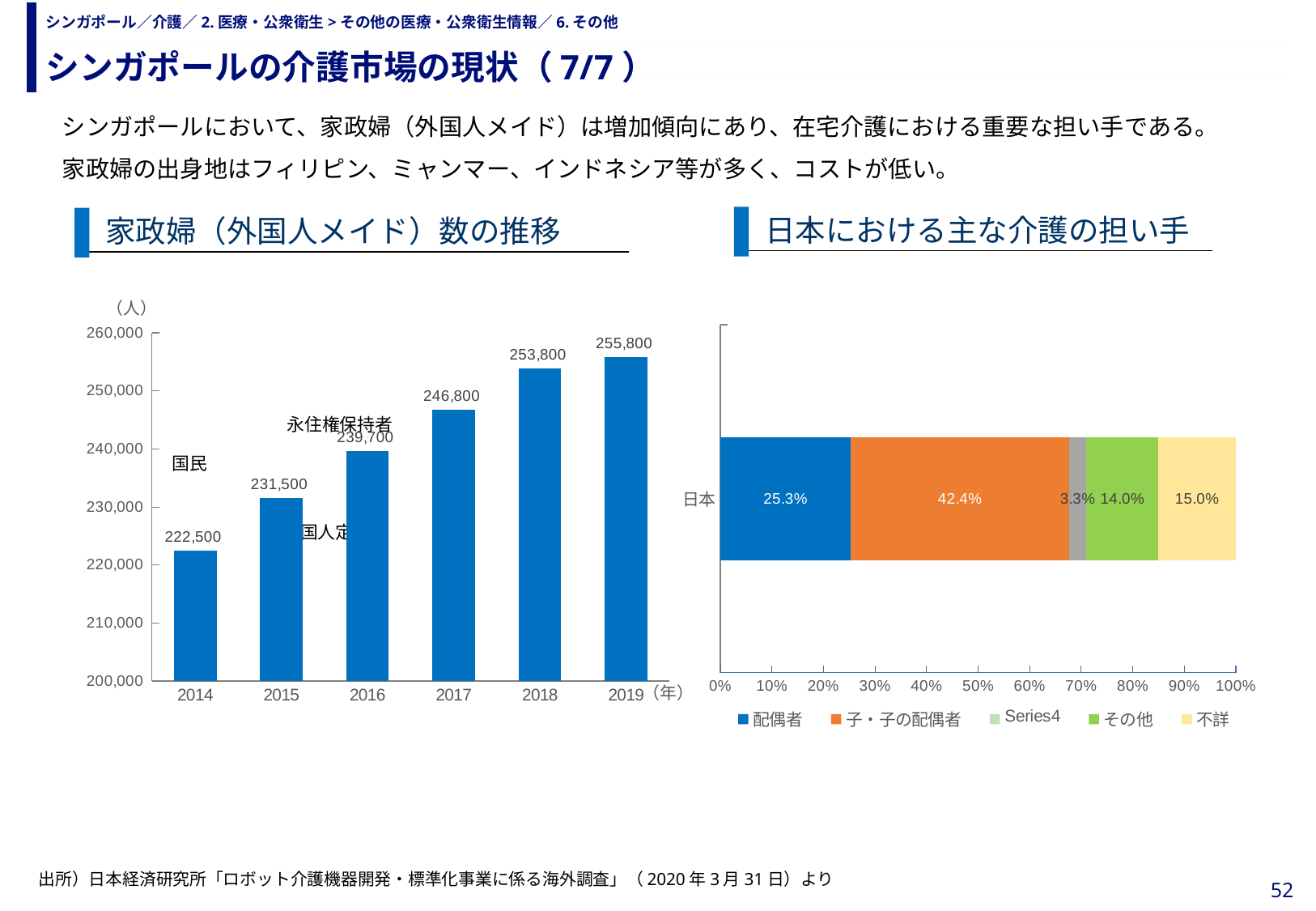
In the chart titled 家政婦（外国人メイド）数の推移, what is the difference between the 2019 value and the 2018 value? 2,000 In the chart titled 家政婦（外国人メイド）数の推移, which year has the highest value? 2019 In the chart titled 家政婦（外国人メイド）数の推移, which year has the lowest value? 2014 In the chart titled 家政婦（外国人メイド）数の推移, what is the value for 2014? 222,500 In the chart titled 日本における主な介護の担い手, what is the value for 子・子の配偶者? 42.4% In the chart titled 家政婦（外国人メイド）数の推移, what is the value for 2017? 246,800 In the chart titled 日本における主な介護の担い手, what is the value for 配偶者? 25.3% In the chart titled 日本における主な介護の担い手, how many series does the legend list? 5 What kind of chart is the chart titled 家政婦（外国人メイド）数の推移? bar chart In the chart titled 家政婦（外国人メイド）数の推移, do the values rise or fall from 2014 to 2019? rise In the chart titled 日本における主な介護の担い手, which is larger, その他 or 不詳? 不詳 In the chart titled 家政婦（外国人メイド）数の推移, how many years are plotted? 6